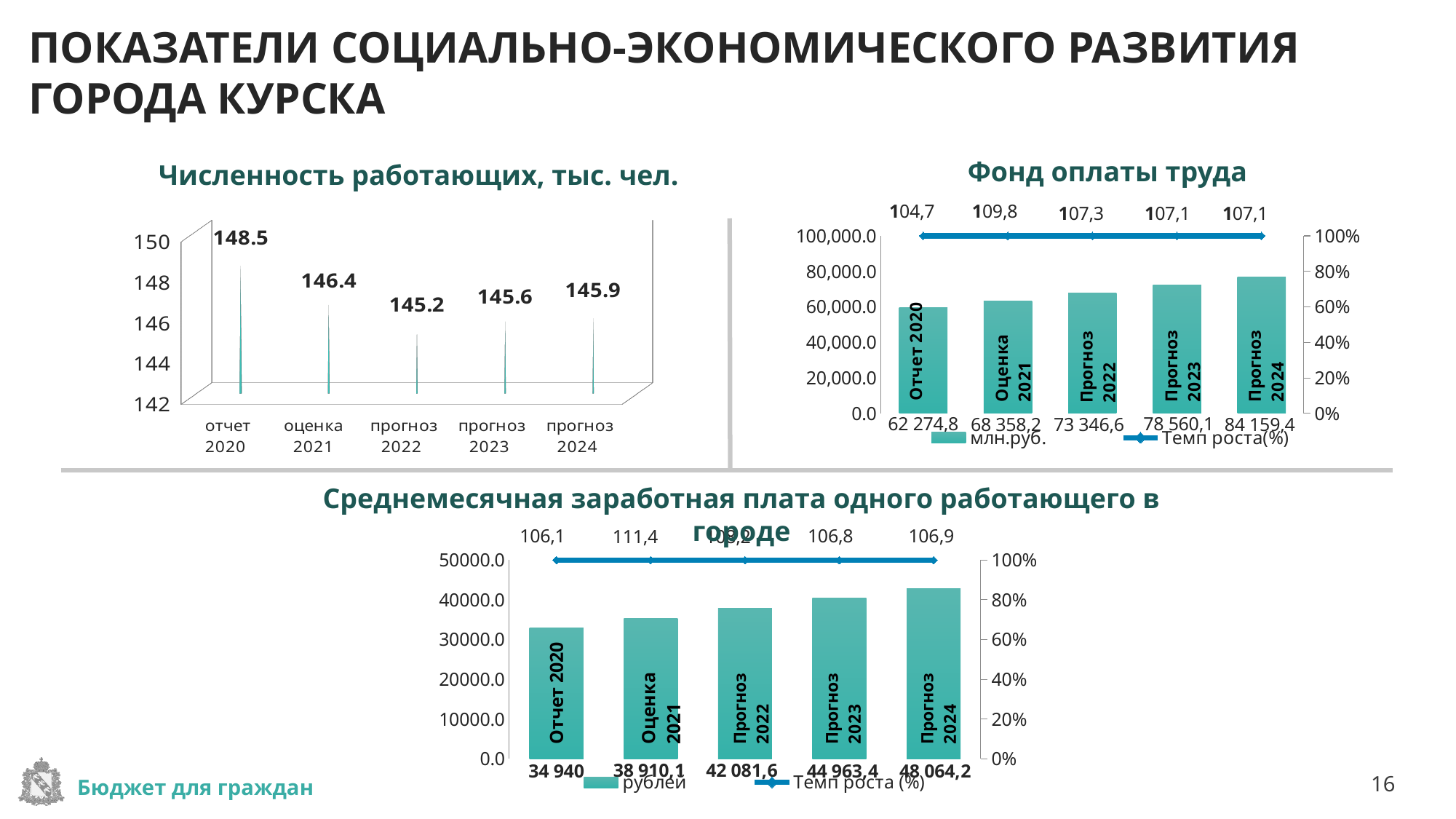
In the chart 'Фонд оплаты труда', do the bar values rise or fall from Отчет 2020 to Прогноз 2024? rise In the chart 'Численность работающих, тыс. чел.', which category has the lowest value? прогноз 2022 In the chart 'Фонд оплаты труда', how many series does the legend list? 2 In the chart 'Фонд оплаты труда', what is the Темп роста(%) value for Оценка 2021? 109,8 In the chart 'Фонд оплаты труда', which category has the highest value in млн.руб.? Прогноз 2024 In the chart 'Численность работающих, тыс. чел.', what is the value for отчет 2020? 148.5 In the chart 'Численность работающих, тыс. чел.', what is the difference between the values for отчет 2020 and оценка 2021? 2.1 In the chart 'Численность работающих, тыс. чел.', how many categories are shown on the x axis? 5 In the chart 'Фонд оплаты труда', what is the value in млн.руб. for Прогноз 2024? 84 159,4 In the chart 'Среднемесячная заработная плата одного работающего в городе', what is the value in рублей for Отчет 2020? 34 940 In the chart 'Среднемесячная заработная плата одного работающего в городе', what is the Темп роста (%) value for Оценка 2021? 111,4